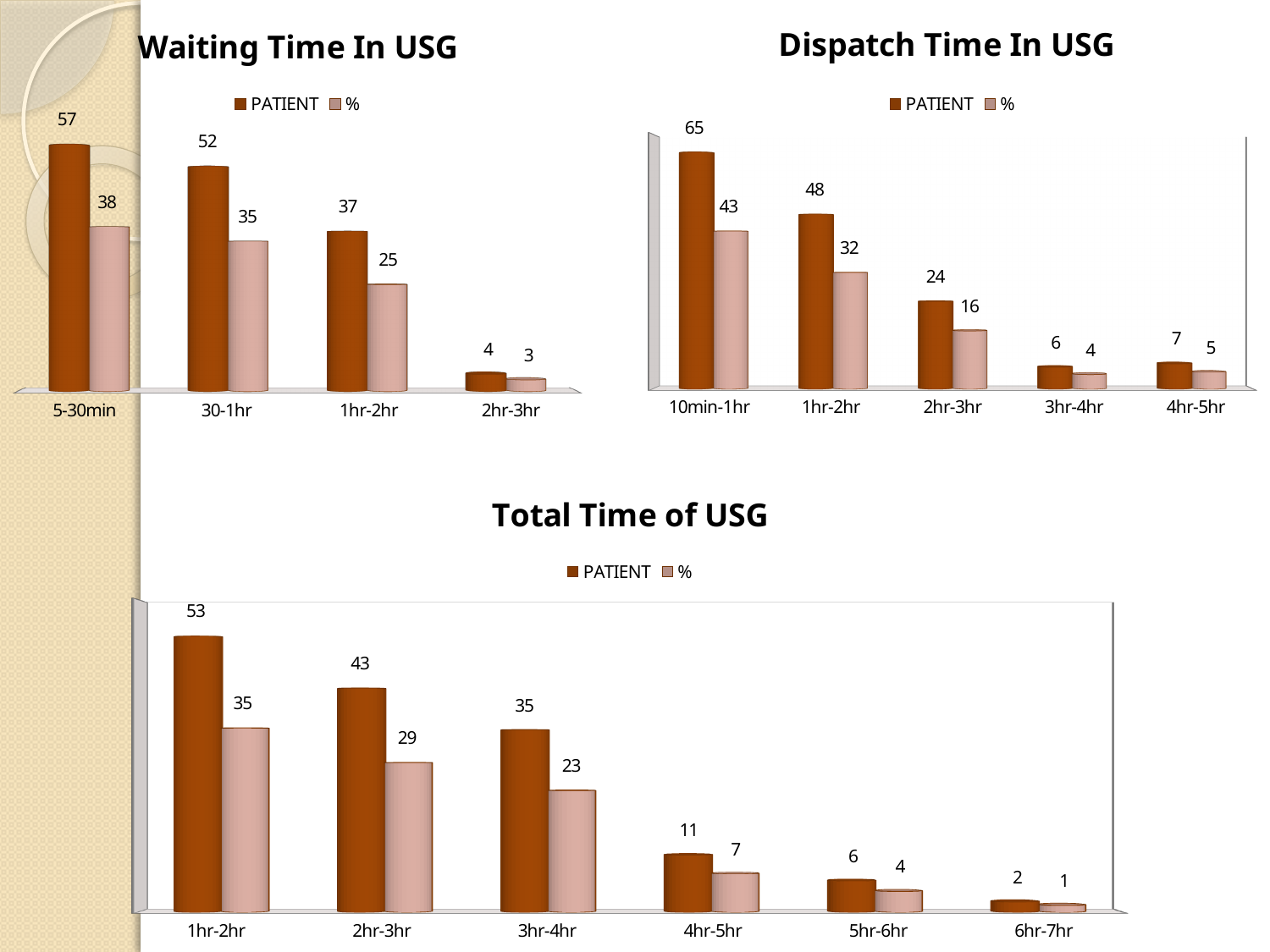
In the 'Dispatch Time In USG' chart, what is the difference between the PATIENT values for 10min-1hr and 1hr-2hr? 17 In the 'Dispatch Time In USG' chart, how many series does the legend list? 2 In the 'Waiting Time In USG' chart, which category has the lowest PATIENT value? 2hr-3hr In the 'Waiting Time In USG' chart, how many categories are shown on the x axis? 4 In the 'Dispatch Time In USG' chart, which category has the highest PATIENT value? 10min-1hr In the 'Dispatch Time In USG' chart, what is the % value for 1hr-2hr? 32 In the 'Total Time of USG' chart, do the PATIENT values rise or fall from left to right along the x axis? fall In the 'Waiting Time In USG' chart, what is the PATIENT value for 30-1hr? 52 In the 'Total Time of USG' chart, how many categories are shown on the x axis? 6 In the 'Total Time of USG' chart, which is larger: the PATIENT value for 2hr-3hr or the PATIENT value for 3hr-4hr? 2hr-3hr In the 'Total Time of USG' chart, what is the PATIENT value for 4hr-5hr? 11 What kind of chart is the 'Total Time of USG' chart? bar chart